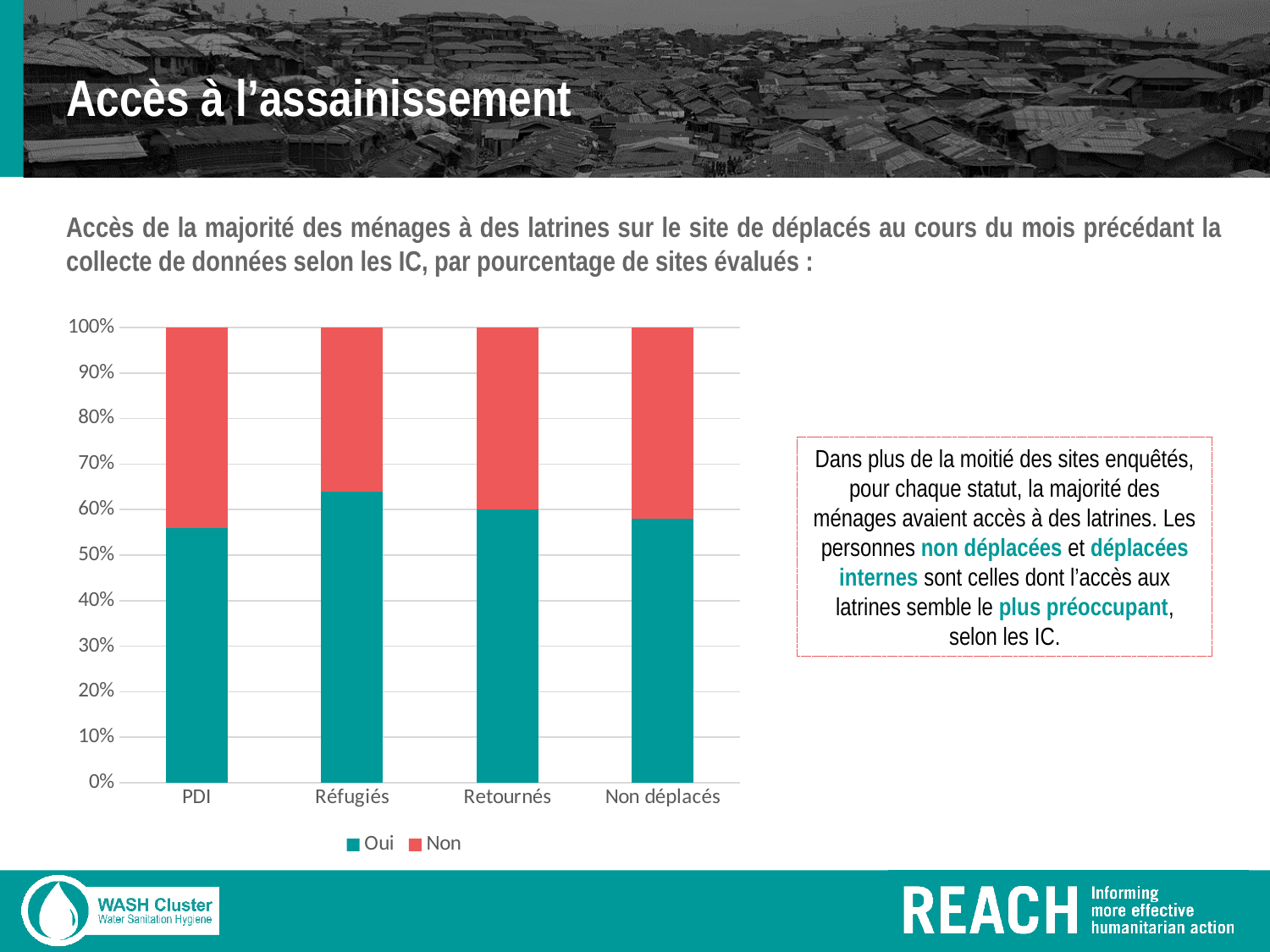
Is the 'Oui' value for PDI greater or less than 50%? greater Which has a larger 'Oui' share: PDI or Réfugiés? Réfugiés Which category has the largest 'Non' share in the chart? PDI How many categories are shown on the x axis of the chart? 4 Is the 'Oui' value for Retournés greater or less than 50%? greater Is the 'Oui' value for Réfugiés greater or less than 60%? greater Which category has the highest 'Oui' share in the chart? Réfugiés How many series does the chart's legend list? 2 What are the two series listed in the chart's legend? Oui and Non What kind of chart is shown on the slide? Stacked bar chart What is the total height of each stacked bar in the chart? 100%